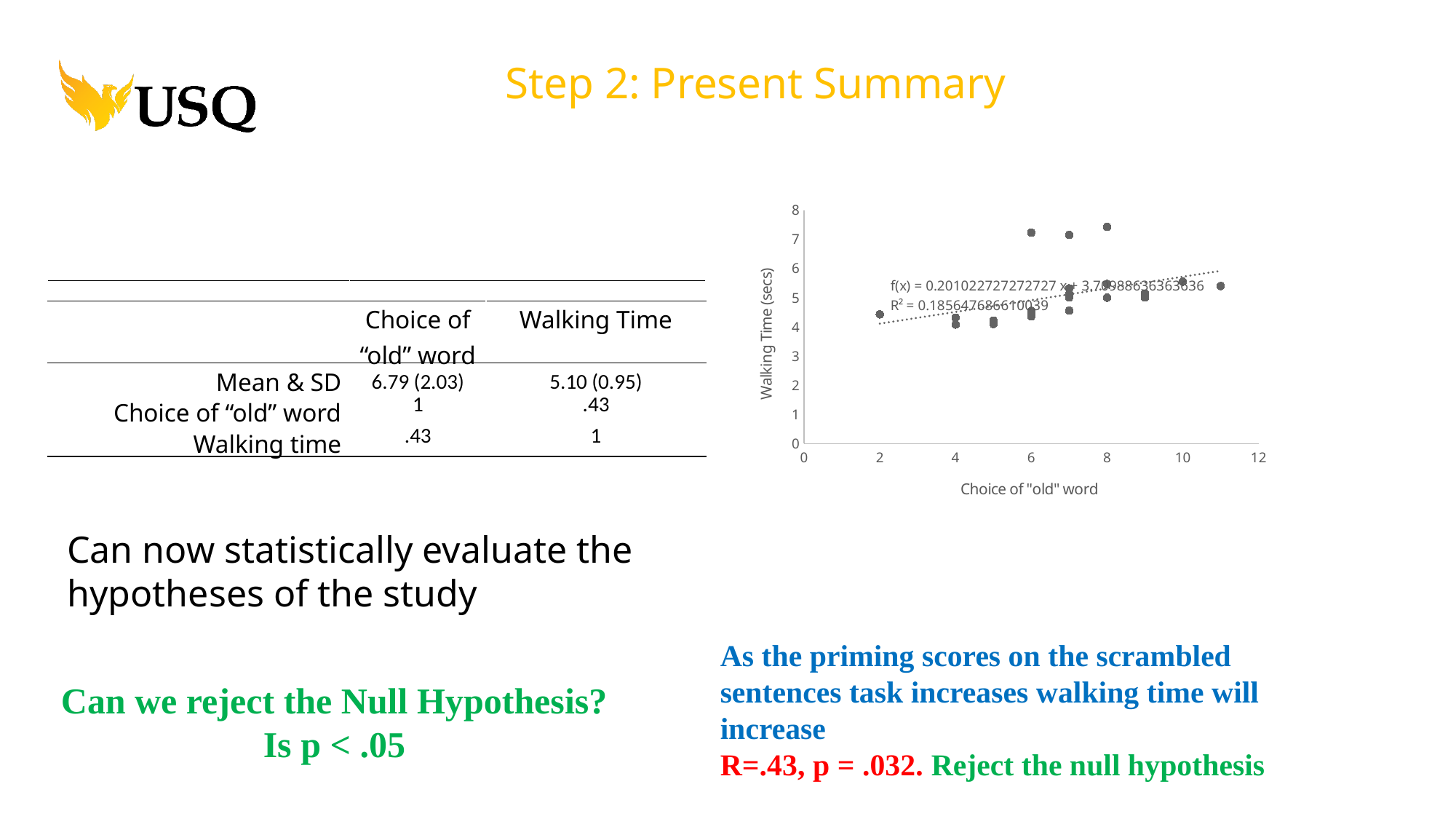
What kind of chart is shown on the slide? scatter chart Is the highest point on the chart, at Choice of "old" word = 8, greater or less than 7? greater What is the title of the vertical axis of the chart? Walking Time (secs) Which has the higher walking time: the point at Choice of "old" word = 2 or the lowest point at Choice of "old" word = 4? the point at 2 Which has the higher walking time: the highest point at Choice of "old" word = 8 or the point at Choice of "old" word = 11? the point at 8 Is the highest point on the chart greater or less than 8? less What R² value is printed on the chart? R² = 0.185647686610039 Is the walking time for the point at Choice of "old" word = 5 greater or less than 5? less Does the dotted trendline on the chart rise or fall as Choice of "old" word increases? rise